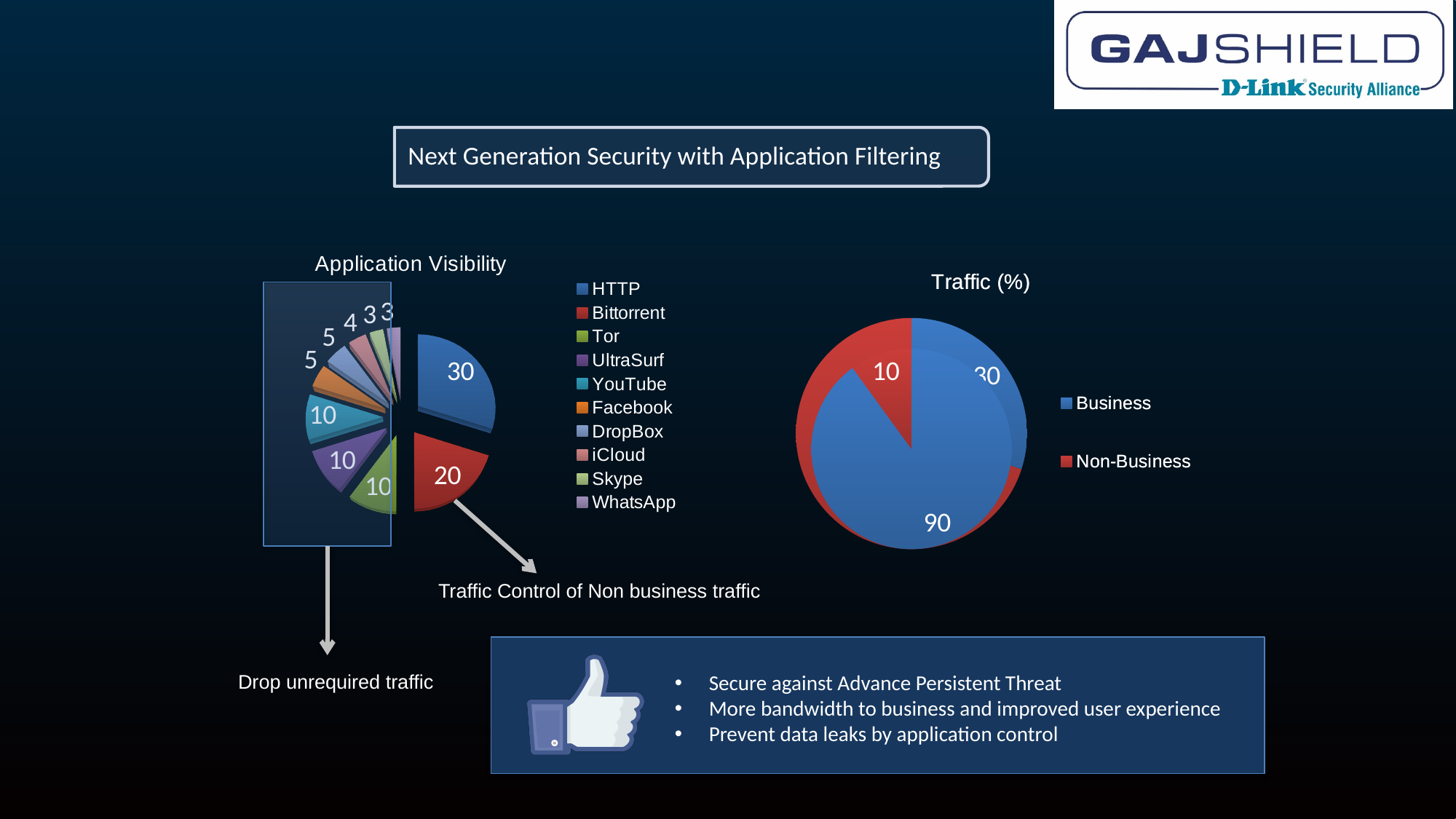
In the Application Visibility chart, which application has the largest slice? HTTP In the Application Visibility chart, what is the value for Facebook? 5 In the Traffic (%) chart, which category has the smaller slice? Non-Business In the Traffic (%) chart, what colour is the Non-Business slice? Red What kind of chart is the Application Visibility chart? Pie chart How many applications are listed in the legend of the Application Visibility chart? 10 In the Application Visibility chart, what is the value for Bittorrent? 20 In the Application Visibility chart, what is the difference between the HTTP and Bittorrent values? 10 In the Application Visibility chart, what is the value for HTTP? 30 In the Traffic (%) chart, what is the value for Business? 90 In the Application Visibility chart, which is larger, the value for Tor or the value for iCloud? Tor In the Traffic (%) chart, what is the value for Non-Business? 10